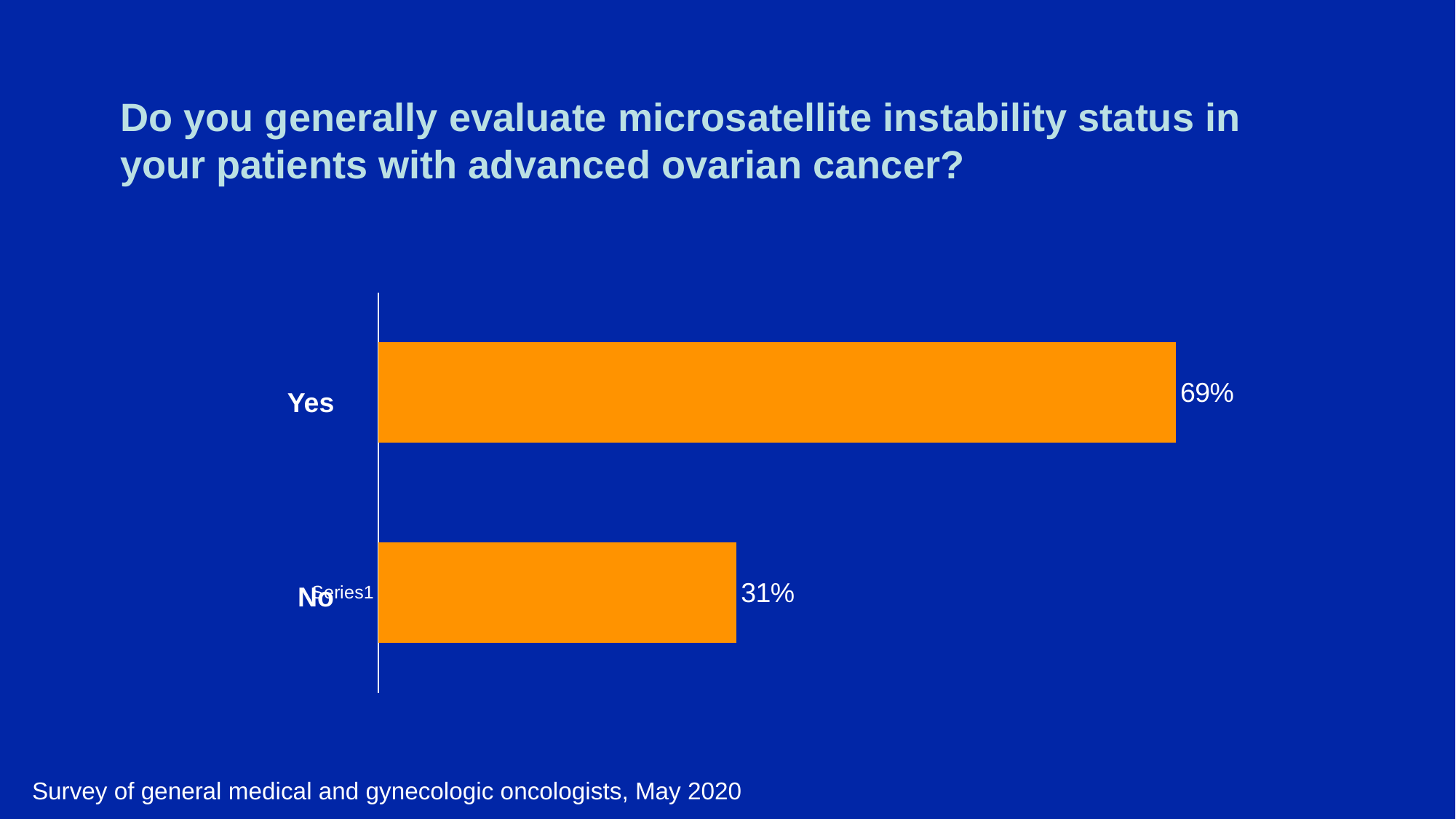
Which response has the higher percentage? Yes What is the difference in percentage points between the Yes and No responses? 38 What colour are the bars in the chart? orange What percentage of respondents answered Yes? 69% How many response categories are shown in the chart? 2 Which response has the lower percentage? No What kind of chart is shown on the slide? bar chart What survey population and date does the slide cite as the source of the data? Survey of general medical and gynecologic oncologists, May 2020 What percentage of respondents answered No? 31% Is the value for Yes larger or smaller than the value for No? larger What is the total of the Yes and No percentages? 100%